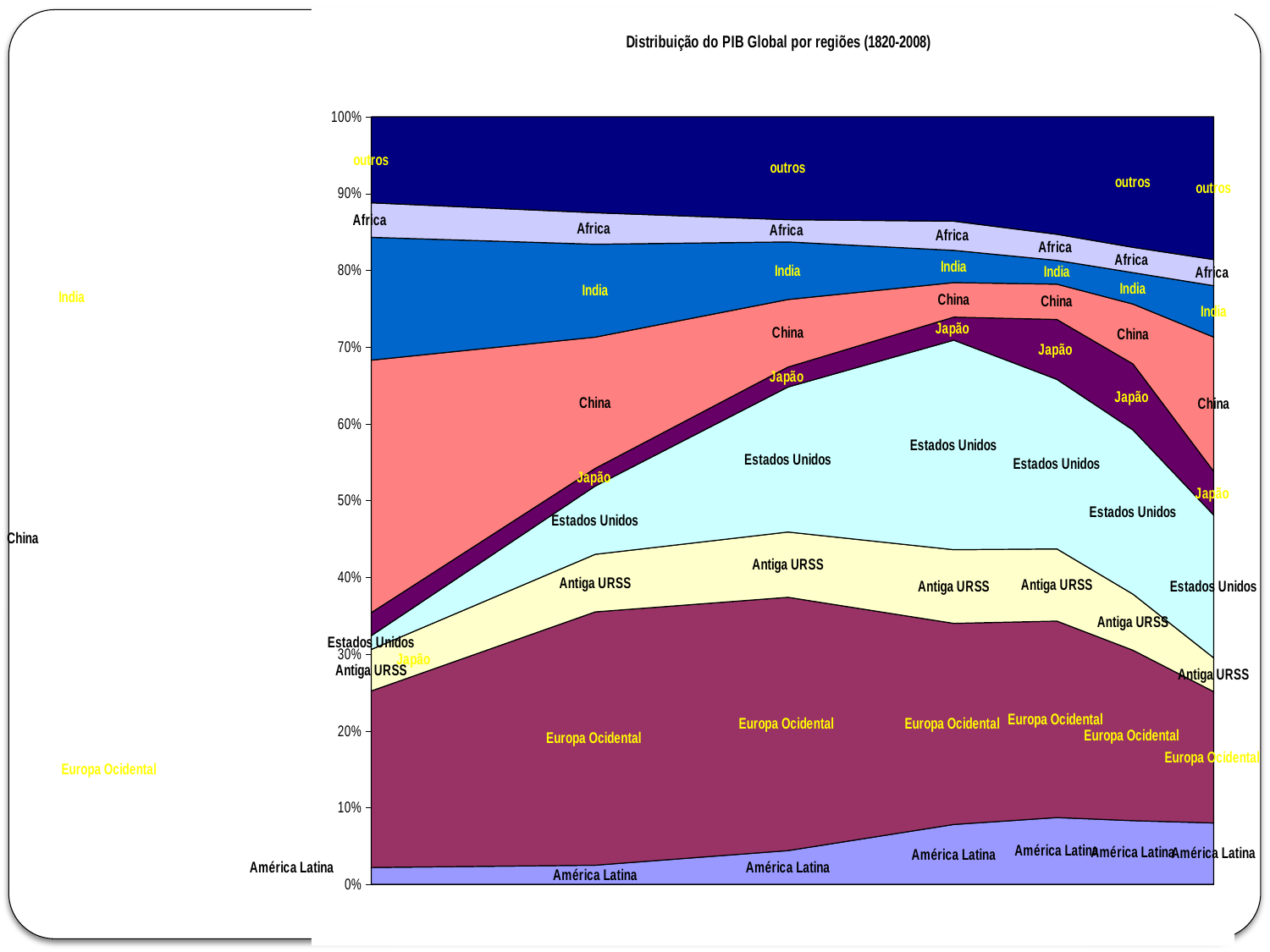
Does the share of India rise or fall across the chart from left to right? fall At the left edge of the chart, which band is larger: China or Japão? China At the right edge of the chart, which band is larger: Estados Unidos or Antiga URSS? Estados Unidos Does the share of China rise or fall from the left edge to the middle of the chart? fall What kind of chart is shown on the slide? stacked area chart How many regions (series) are stacked in the chart? 9 What is the maximum value shown on the vertical axis? 100% Does the share of Estados Unidos rise or fall from the middle of the chart to the right edge? fall Which region forms the top band of the stacked area chart? outros What is the title of the chart? Distribuição do PIB Global por regiões (1820-2008)